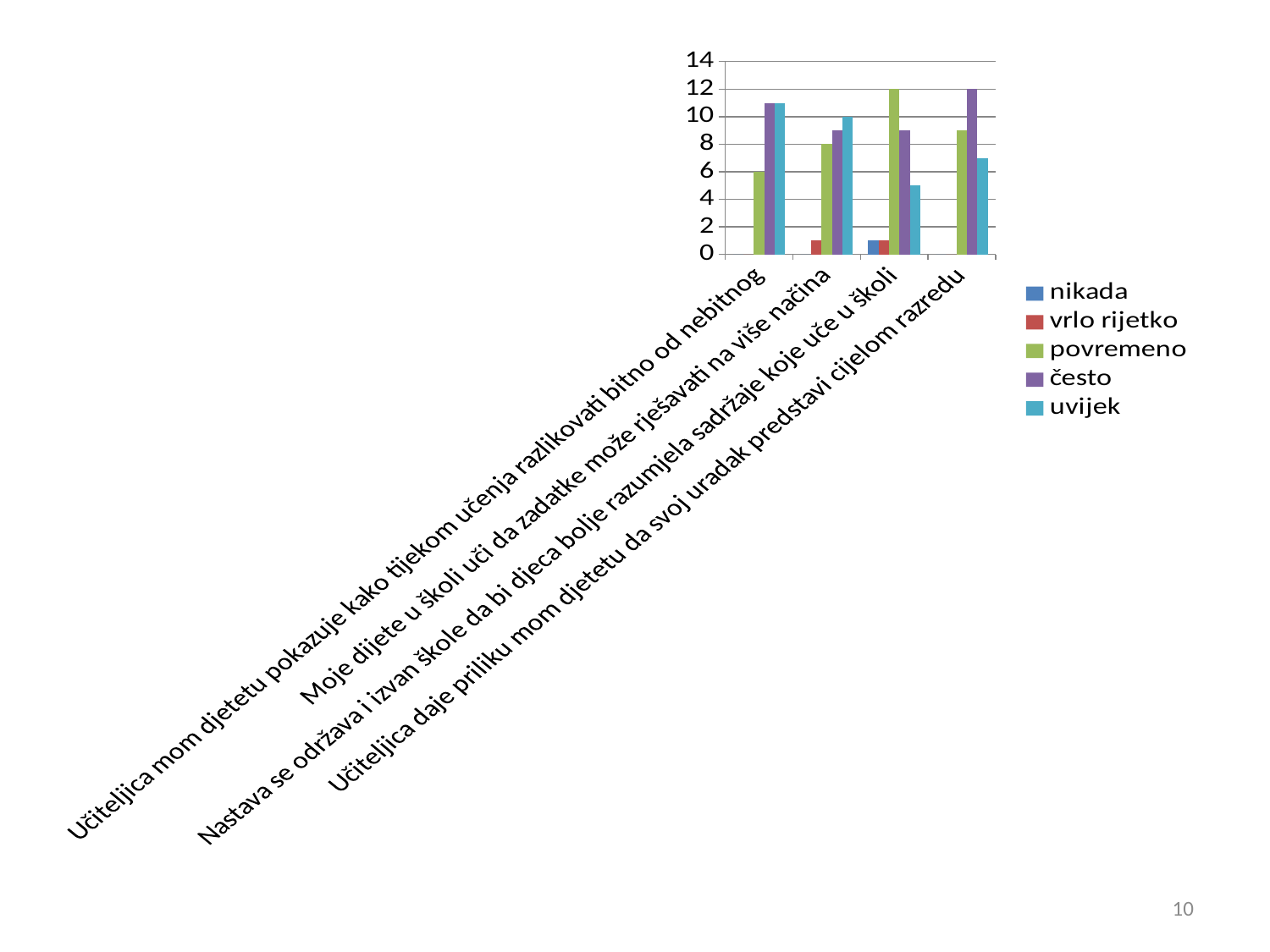
What is the difference between the "povremeno" value for "Nastava se održava i izvan škole da bi djeca bolje razumjela sadržaje koje uče u školi" and the "povremeno" value for "Učiteljica mom djetetu pokazuje kako tijekom učenja razlikovati bitno od nebitnog"? 6 What is the value of "povremeno" for "Nastava se održava i izvan škole da bi djeca bolje razumjela sadržaje koje uče u školi"? 12 What is the value of "često" for "Učiteljica daje priliku mom djetetu da svoj uradak predstavi cijelom razredu"? 12 What is the value of "povremeno" for "Učiteljica mom djetetu pokazuje kako tijekom učenja razlikovati bitno od nebitnog"? 6 How many categories are shown on the x axis? 4 What kind of chart is shown on the slide? bar chart How many series does the legend list? 5 Is the value of "često" for "Učiteljica mom djetetu pokazuje kako tijekom učenja razlikovati bitno od nebitnog" greater or less than 10? greater Which series has the highest bar for "Nastava se održava i izvan škole da bi djeca bolje razumjela sadržaje koje uče u školi"? povremeno For "Učiteljica daje priliku mom djetetu da svoj uradak predstavi cijelom razredu", which is larger: "često" or "uvijek"? često What is the value of "uvijek" for "Moje dijete u školi uči da zadatke može rješavati na više načina"? 10 Is the value of "uvijek" for "Nastava se održava i izvan škole da bi djeca bolje razumjela sadržaje koje uče u školi" greater or less than 6? less